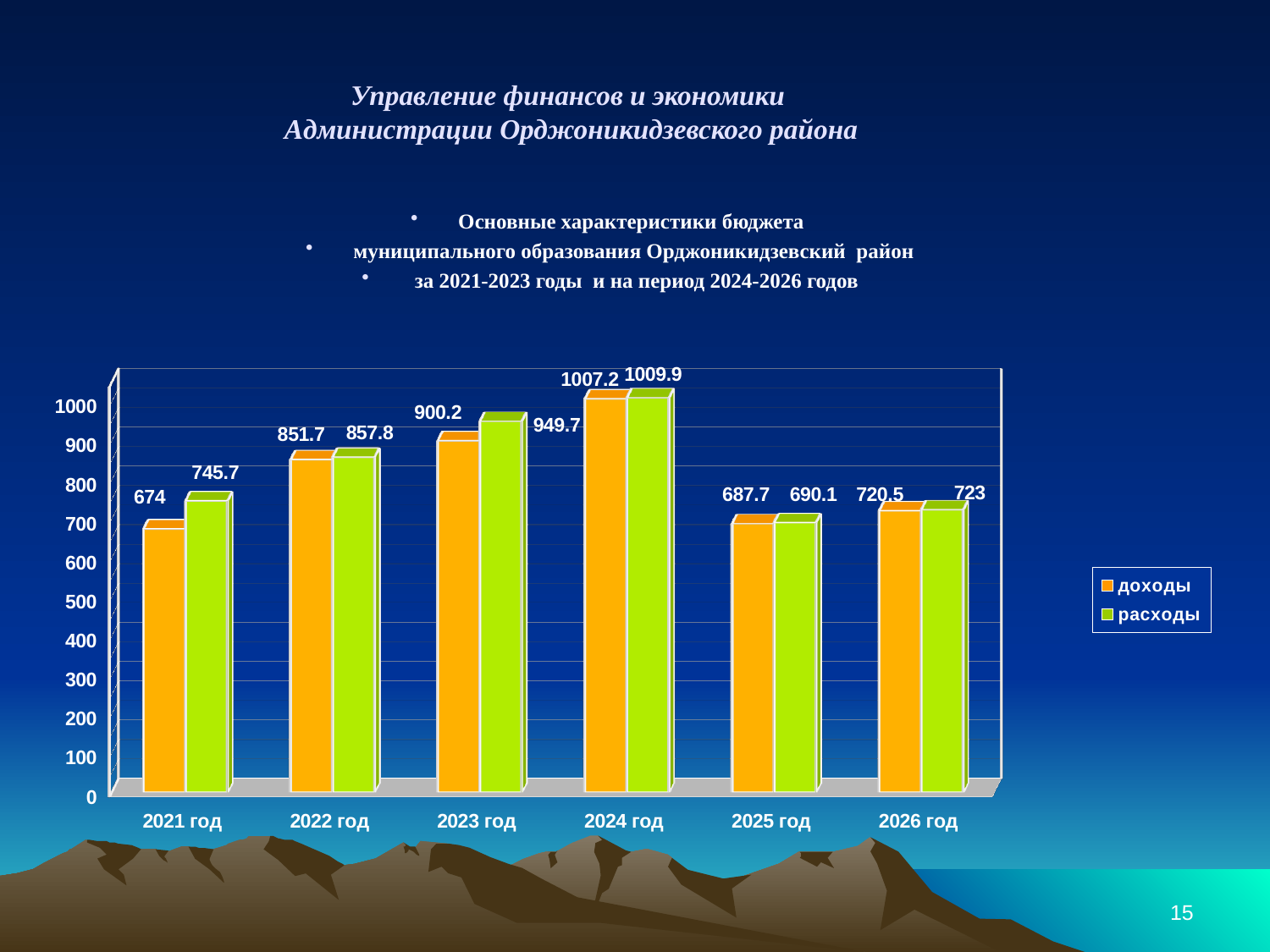
Which colour represents расходы in the legend? green What is the difference between доходы for 2024 год and доходы for 2025 год? 319.5 Which is larger: доходы for 2022 год or доходы for 2026 год? доходы for 2022 год Which year has the lowest value of доходы? 2021 год What kind of chart is shown on the slide? bar chart Which year has the highest value of расходы? 2024 год What is the difference between расходы and доходы for 2021 год? 71.7 What is the value of расходы for 2023 год? 949.7 What is the value of доходы for 2021 год? 674 What is the value of доходы for 2026 год? 720.5 How many years are shown on the x axis? 6 How many series does the legend list? 2